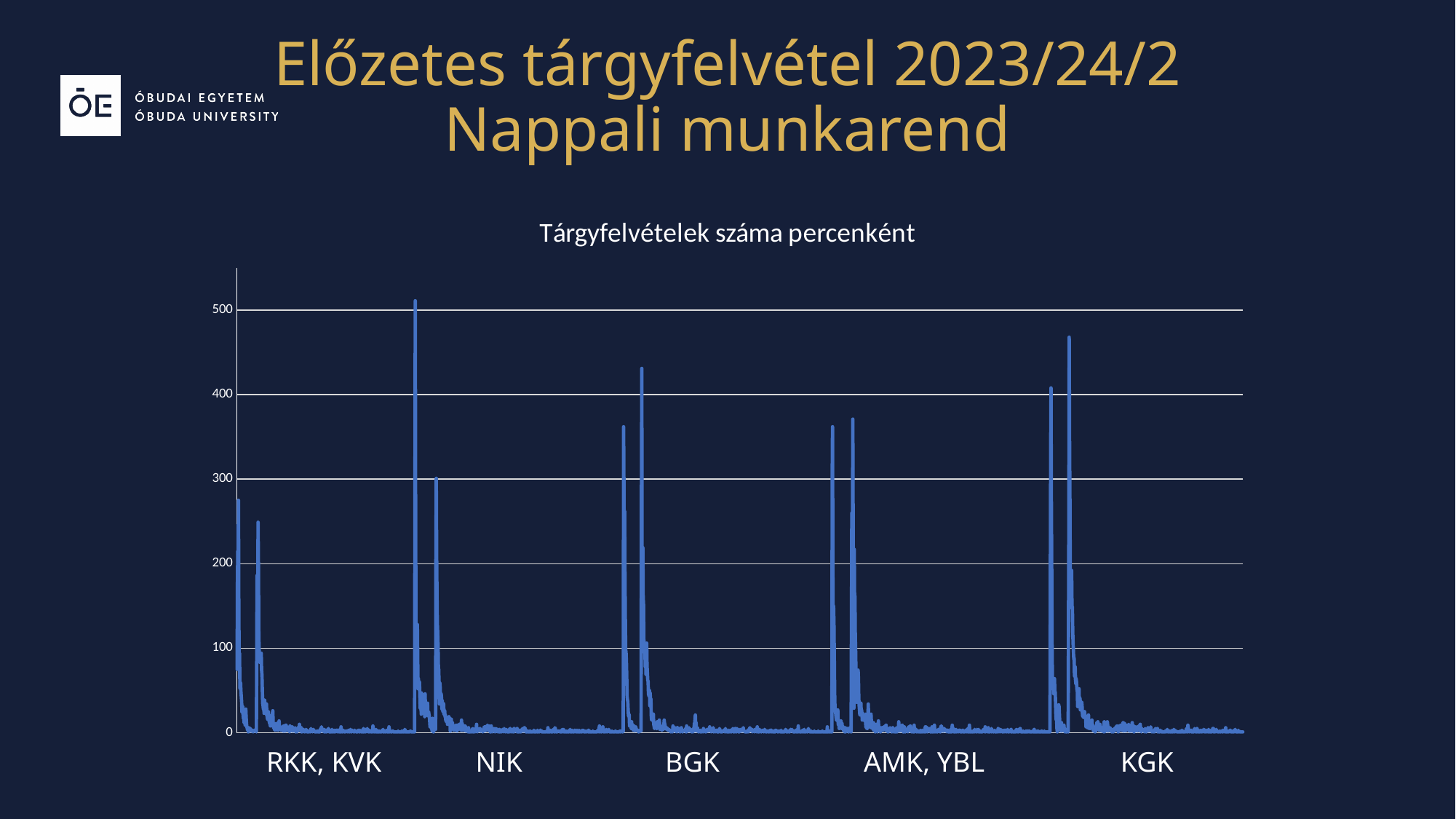
Which has a higher peak: the BGK section or the AMK, YBL section? BGK Which x-axis group contains the highest peak in the chart? NIK How many group labels are shown along the x axis of the chart? 5 Is the highest peak in the BGK section greater or less than 400? greater What is the title of the chart? Tárgyfelvételek száma percenként Which x-axis group has the lowest maximum peak in the chart? RKK, KVK Is the highest peak in the RKK, KVK section greater or less than 300? less What is the highest value labelled on the y axis of the chart? 500 Which has a higher peak: the NIK section or the KGK section? NIK Is the highest peak in the KGK section greater or less than 400? greater What kind of chart is shown on the slide? line chart